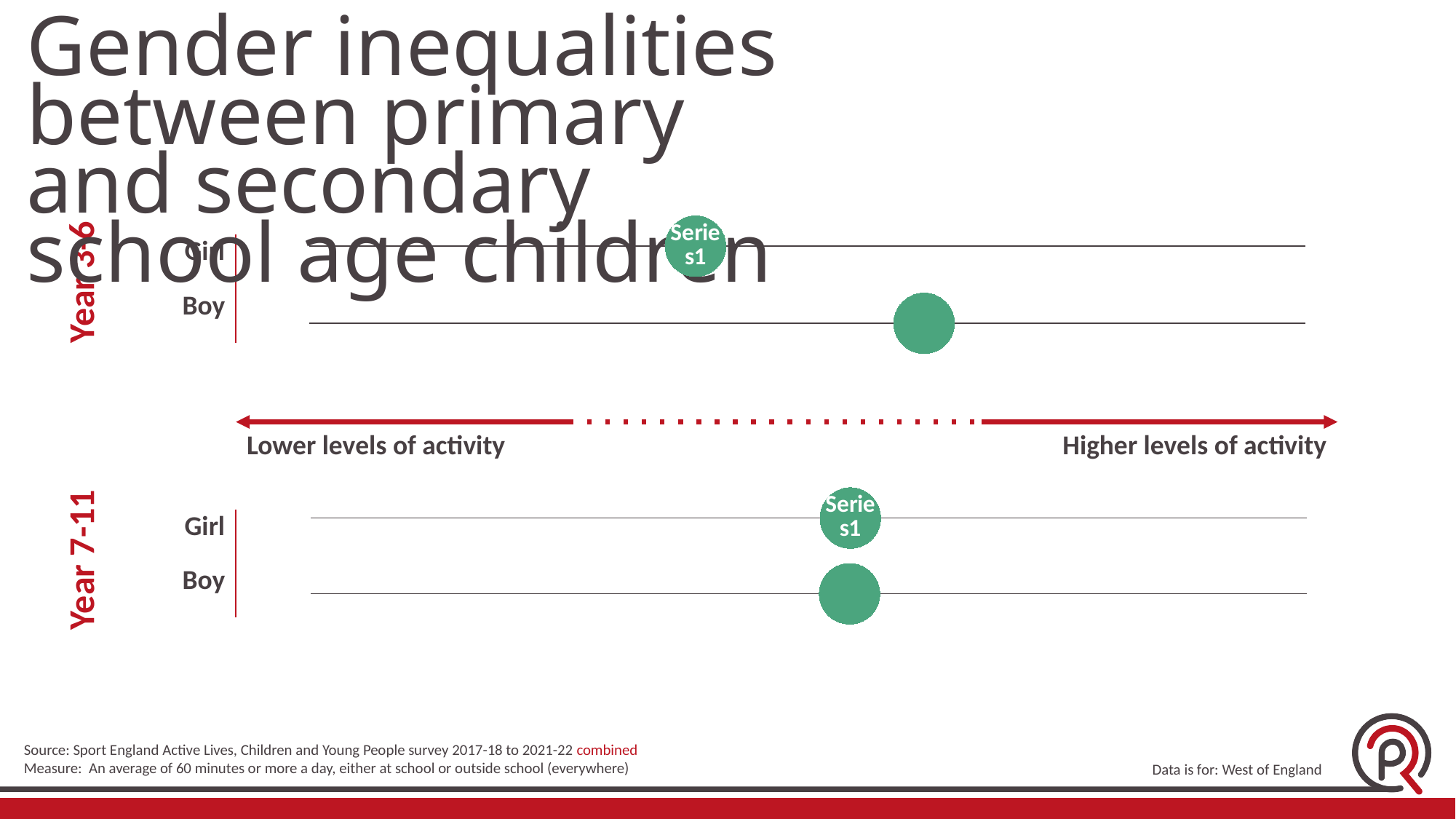
How many categories are plotted in the Year 3-6 chart? 2 Which year group's chart shows the larger gap between the Girl and Boy markers, Year 3-6 or Year 7-11? Year 3-6 In the Year 3-6 chart, which group's marker is further toward higher levels of activity, Girl or Boy? Boy How many categories are plotted in the Year 7-11 chart? 2 What kind of chart is used to show the Girl and Boy positions on this slide? dot plot What are the two categories shown in the Year 7-11 chart? Girl and Boy What label appears at the right end of the horizontal activity axis? Higher levels of activity In the Year 3-6 chart, which group's marker is closer to the lower levels of activity end? Girl